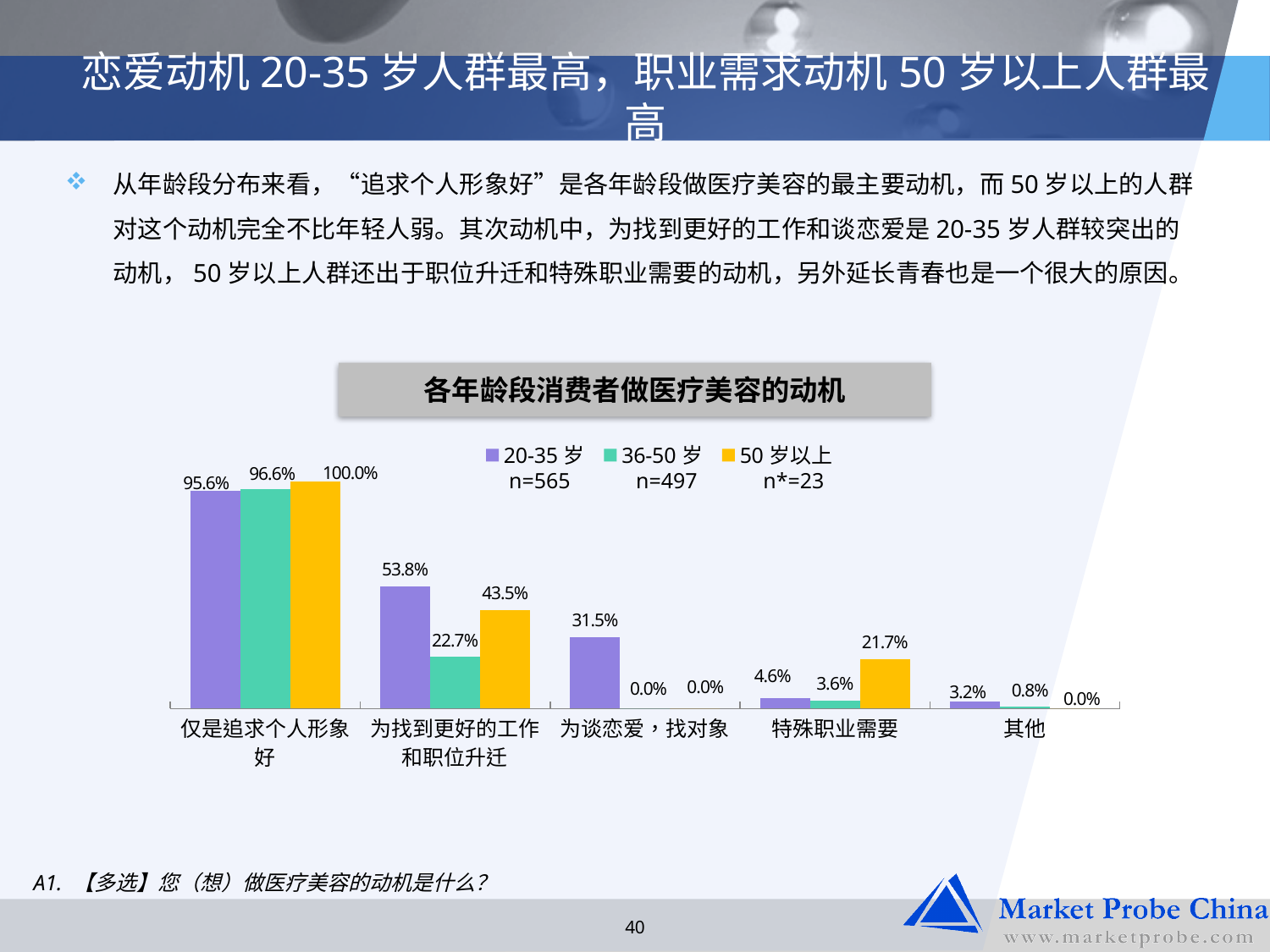
What is the sample size (n) shown in the legend for the 36-50 岁 group? n=497 What is the value for 36-50 岁 in the category 仅是追求个人形象好? 96.6% How many series does the legend list? 3 What is the value for 20-35 岁 in the category 为找到更好的工作和职位升迁? 53.8% What is the difference between the 20-35 岁 and 36-50 岁 values in the category 为找到更好的工作和职位升迁? 31.1% What is the value for 50 岁以上 in the category 特殊职业需要? 21.7% Which age group has the lowest value in the category 为找到更好的工作和职位升迁? 36-50 岁 How many categories are shown on the x axis of the chart? 5 What is the value for 20-35 岁 in the category 为谈恋爱，找对象? 31.5% What kind of chart is shown on the slide? Bar chart Which is larger in the category 特殊职业需要: the value for 20-35 岁 or for 36-50 岁? 20-35 岁 Which age group has the highest value in the category 仅是追求个人形象好? 50 岁以上